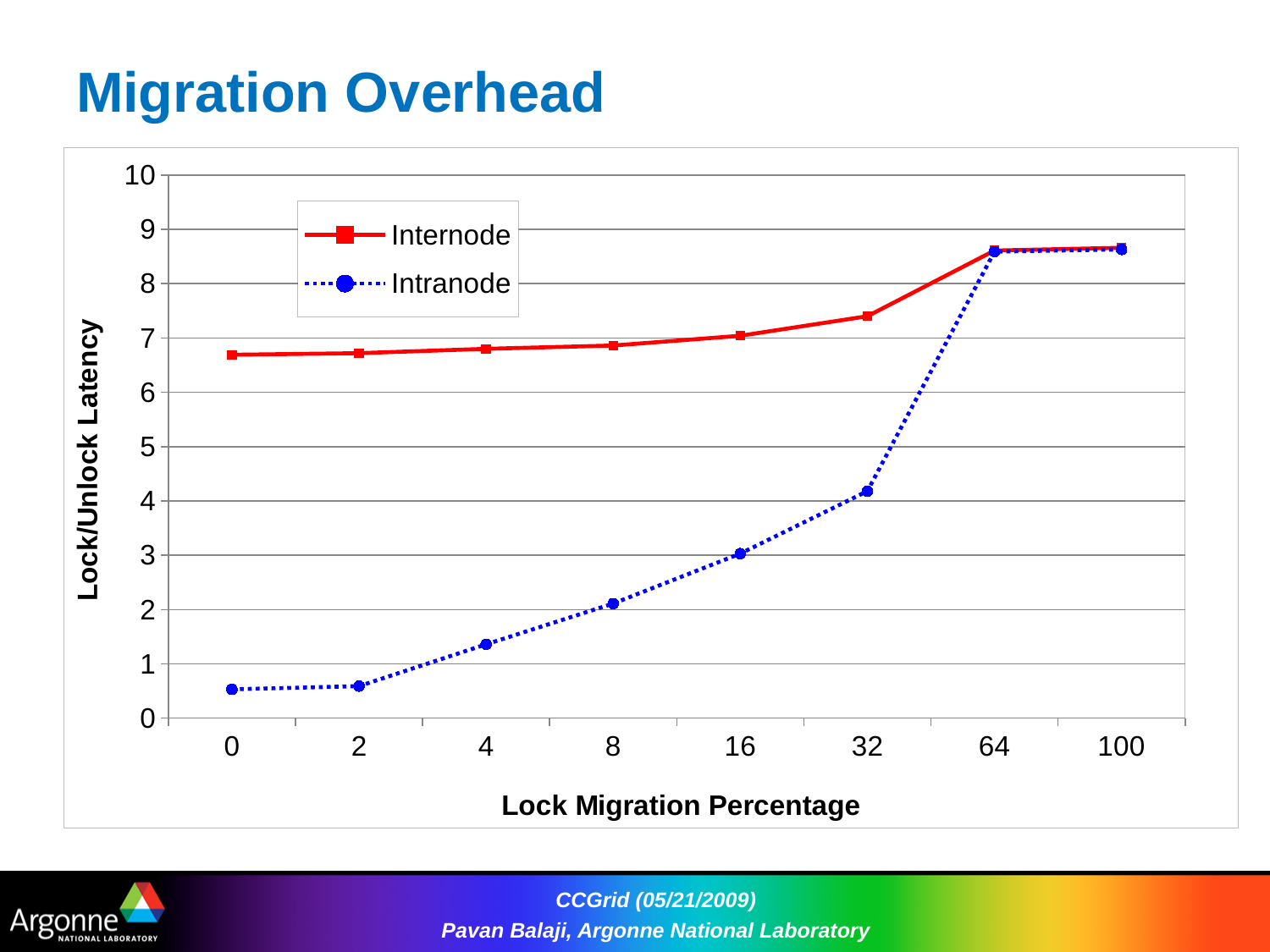
What is the title of the y axis? Lock/Unlock Latency At a Lock Migration Percentage of 16, which series has the higher latency, Internode or Intranode? Internode How many series does the legend list? 2 Is the Intranode value at a Lock Migration Percentage of 8 greater or less than 3? less Is the Intranode value at a Lock Migration Percentage of 32 greater or less than 5? less What is the title of the x axis? Lock Migration Percentage What kind of chart is shown on the slide? line chart Is the Internode value at a Lock Migration Percentage of 0 greater or less than 6? greater Does the Intranode series rise or fall as Lock Migration Percentage increases from 0 to 100? rise How many Lock Migration Percentage values are plotted along the x axis? 8 For the Intranode series, is the value at 64 or the value at 32 larger? 64